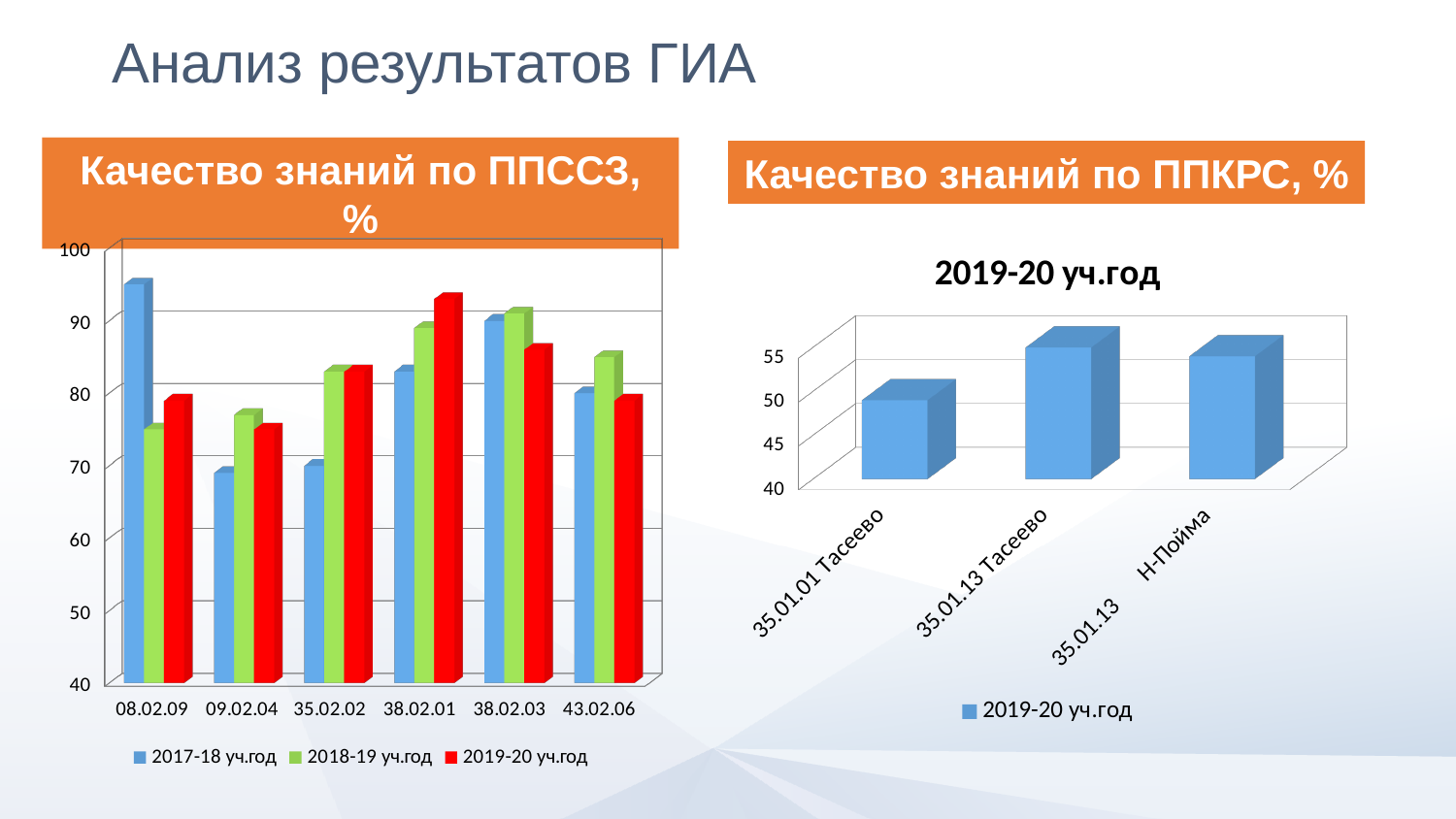
On the chart 'Качество знаний по ППССЗ, %', which category has the highest value for 2019-20 уч.год? 38.02.01 What kind of chart is 'Качество знаний по ППССЗ, %'? bar chart On the chart 'Качество знаний по ППССЗ, %', is the value for 08.02.09 in 2017-18 уч.год greater or less than 90? greater On the chart 'Качество знаний по ППКРС, %', which category has the lowest value? 35.01.01 Тасеево On the chart 'Качество знаний по ППССЗ, %', for 08.02.09, which is larger: 2017-18 уч.год or 2019-20 уч.год? 2017-18 уч.год On the chart 'Качество знаний по ППССЗ, %', which category has the highest value for 2017-18 уч.год? 08.02.09 On the chart 'Качество знаний по ППССЗ, %', how many categories are shown on the x axis? 6 On the chart 'Качество знаний по ППКРС, %', what series name does the legend show? 2019-20 уч.год On the chart 'Качество знаний по ППССЗ, %', how many series does the legend list? 3 On the chart 'Качество знаний по ППКРС, %', how many categories are shown? 3